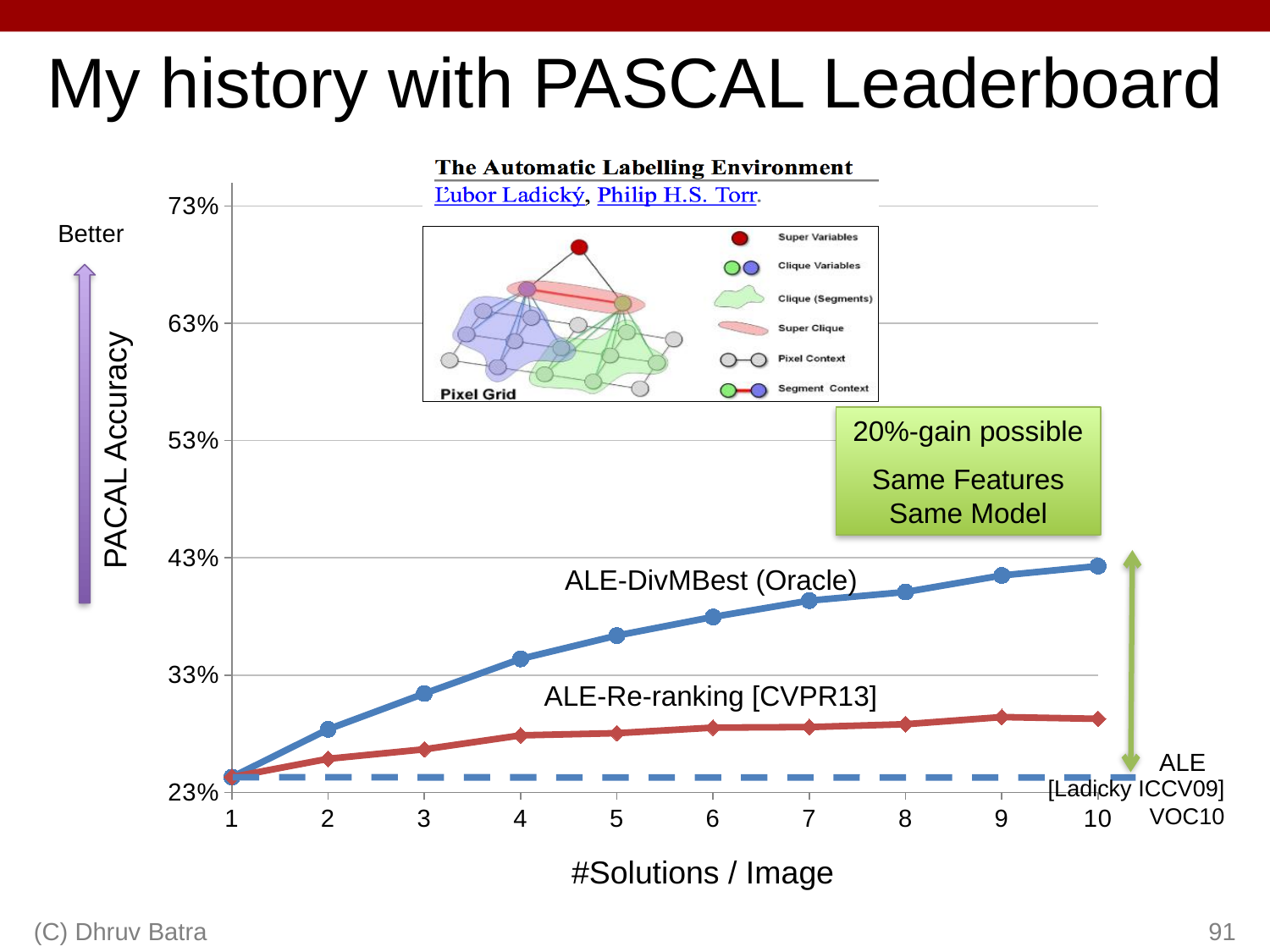
What is the label of the x axis? #Solutions / Image Which series has the highest value at 10 solutions per image? ALE-DivMBest (Oracle) What is the label of the y axis? PACAL Accuracy Is the ALE-Re-ranking [CVPR13] value at 10 solutions per image greater or less than 33%? less At 10 solutions per image, which is higher: ALE-DivMBest (Oracle) or ALE-Re-ranking [CVPR13]? ALE-DivMBest (Oracle) Does the ALE-DivMBest (Oracle) line rise or fall as #Solutions / Image increases from 1 to 10? rise How many points (#Solutions / Image values) are plotted along the x axis? 10 Is the ALE-DivMBest (Oracle) value at 1 solution per image greater or less than 33%? less Is the ALE-DivMBest (Oracle) value at 5 solutions per image greater or less than 33%? greater What kind of chart is shown on the slide? line chart